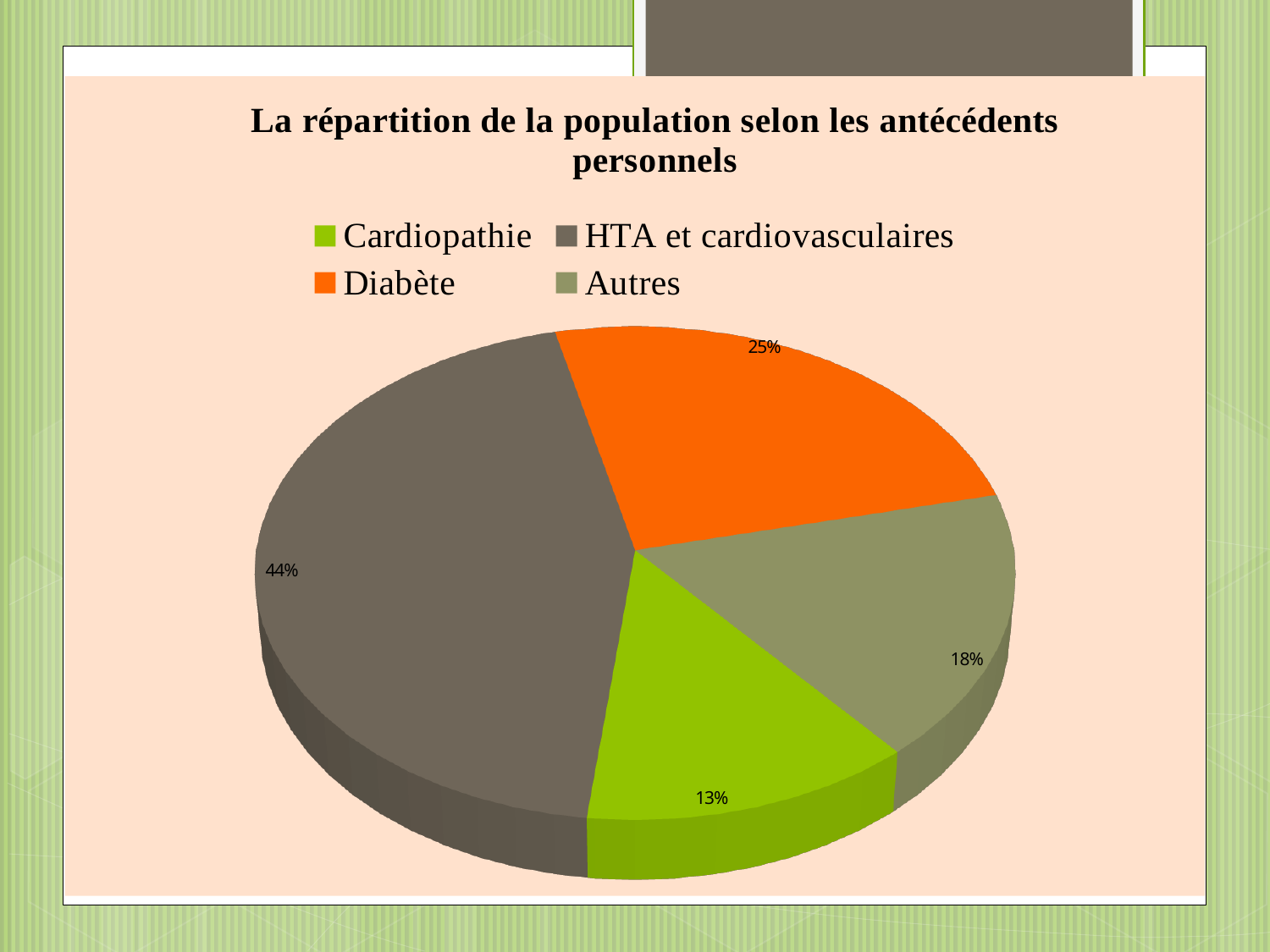
What type of chart is shown on the slide? Pie chart What percentage of the population has HTA et cardiovasculaires as personal history? 44% Which category has the largest share of the pie? HTA et cardiovasculaires What is the title of the chart? La répartition de la population selon les antécédents personnels What percentage is shown for Autres? 18% How many categories does the legend list? 4 What percentage is shown for Cardiopathie? 13% What is the difference in percentage points between HTA et cardiovasculaires and Diabète? 19 What percentage is shown for Diabète? 25% Which is larger, the share for Autres or the share for Cardiopathie? Autres Which colour represents Diabète in the chart? Orange Which category has the smallest share of the pie? Cardiopathie